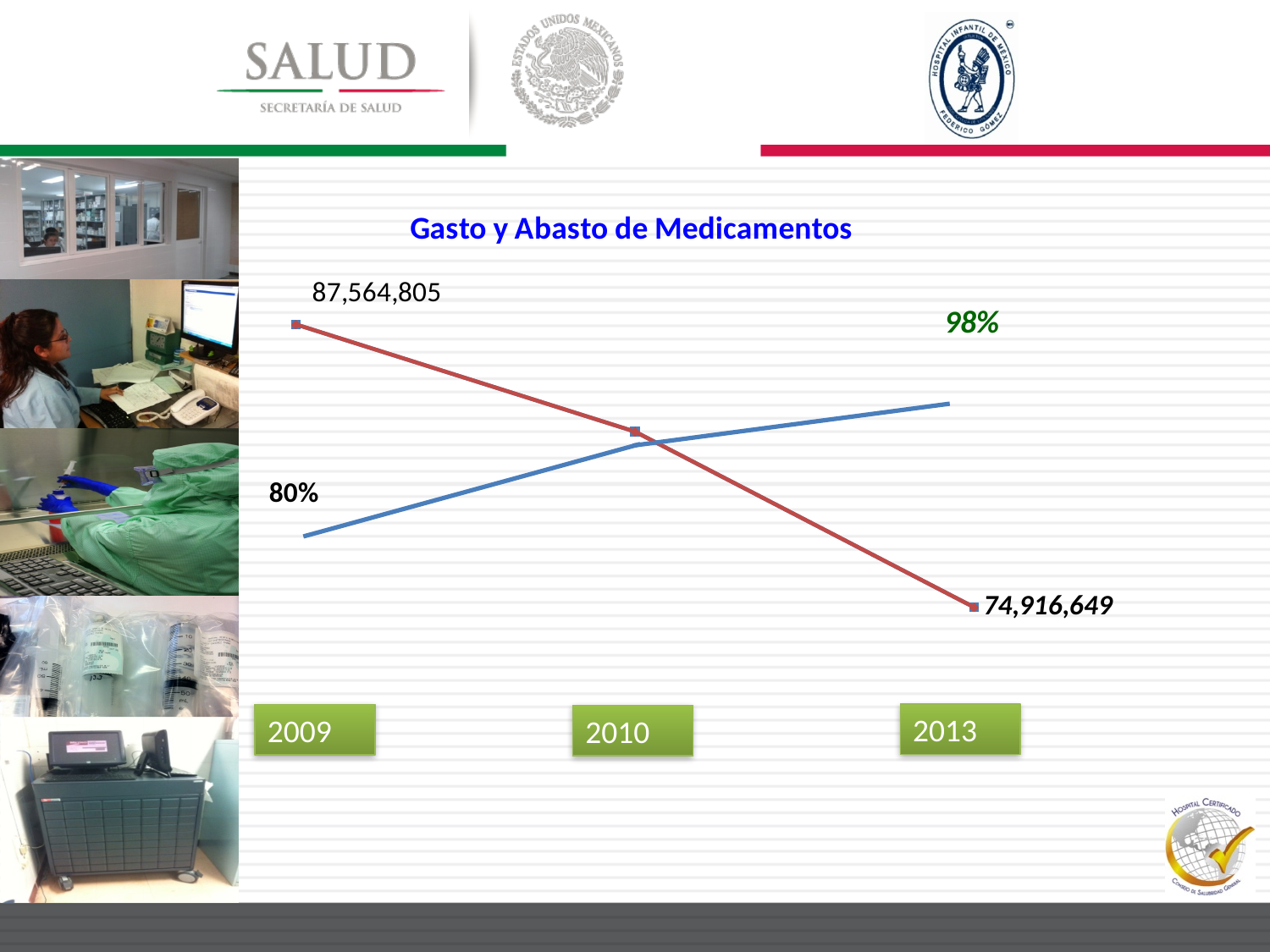
Which year has the higher value on the red line, 2009 or 2013? 2009 What value is labelled on the red line for 2013? 74,916,649 What kind of chart is shown on the slide? line chart How many years are labelled along the x axis of the chart? 3 By how much did the red line's value decrease from 2009 (87,564,805) to 2013 (74,916,649)? 12,648,156 By how many percentage points did the blue line increase from 80% in 2009 to 98% in 2013? 18 What percentage is labelled on the blue line for 2013? 98% What percentage is labelled on the blue line for 2009? 80% Does the red line rise or fall from 2009 to 2013? fall What is the title of the chart? Gasto y Abasto de Medicamentos What value is labelled on the red line for 2009? 87,564,805 Does the blue line rise or fall from 2009 to 2013? rise